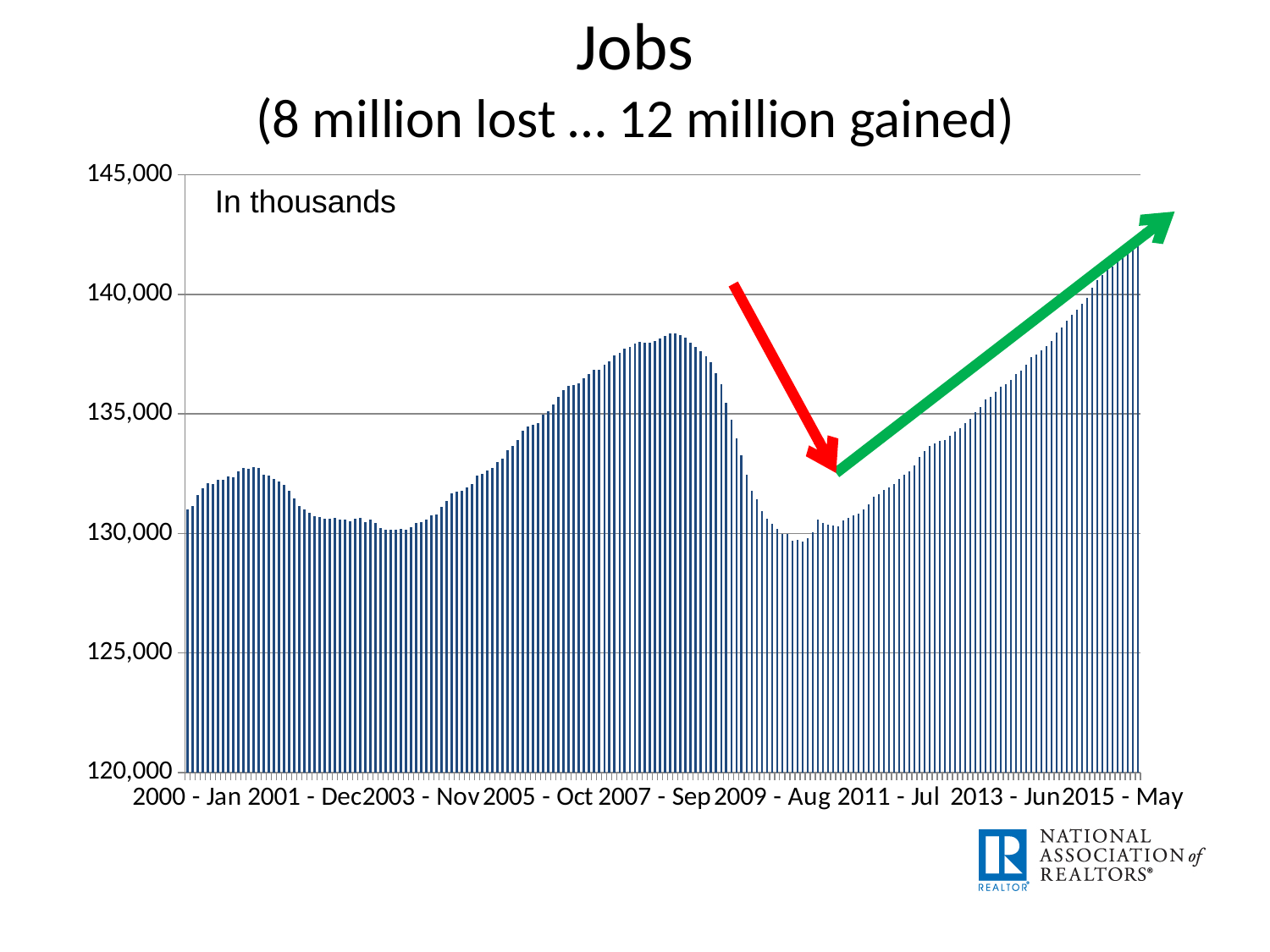
Which is larger, the value for 2015 - May or the value for 2007 - Sep? 2015 - May Is the value for 2009 - Aug greater or less than 135,000? less Is the value for 2015 - May greater or less than 140,000? greater Do the values rise or fall from 2011 - Jul to 2015 - May? rise What is the title of the chart? Jobs (8 million lost … 12 million gained) Is the value for 2011 - Jul greater or less than 135,000? less Which x-axis label has the highest value on the chart? 2015 - May Do the values rise or fall from 2007 - Sep to 2009 - Aug? fall What kind of chart is shown on the slide? bar chart In what units are the values plotted, according to the note inside the chart? In thousands